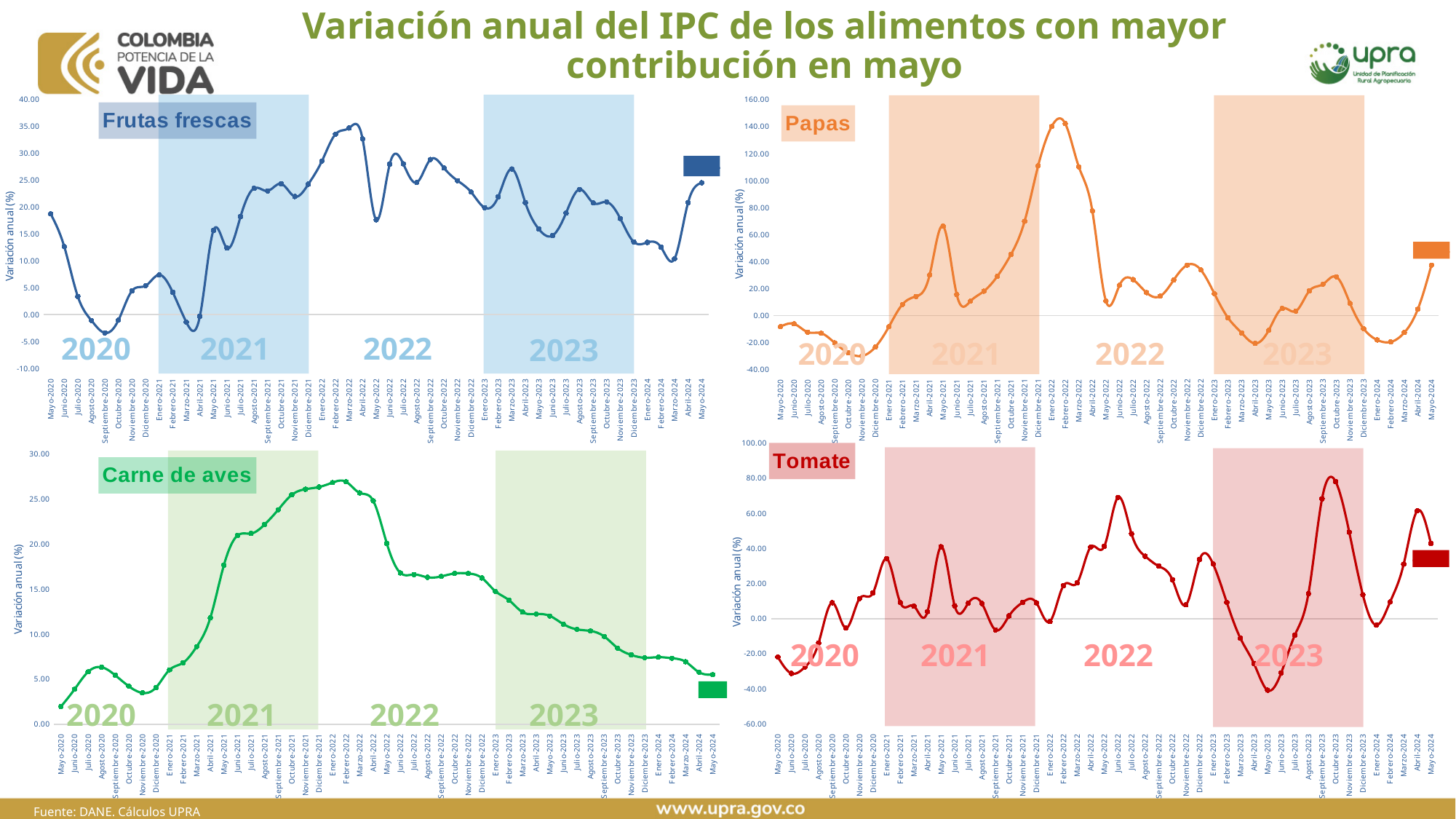
In which year does the Tomate chart reach its lowest value? 2023 In the Papas chart, is the value for Febrero-2022 greater or less than 120? greater In the Carne de aves chart, do the values rise or fall from Enero-2023 to Mayo-2024? fall In the Frutas frescas chart, is the value for Mayo-2020 greater or less than 15? greater What is the label on the vertical axis of the Tomate chart? Variación anual (%) In the Tomate chart, is the value for Mayo-2023 greater or less than -20? less What kind of chart is the Frutas frescas chart? line chart In which year does the Papas chart reach its highest value? 2022 How many charts are shown on the slide? 4 In the Carne de aves chart, which is larger, the value for Febrero-2022 or the value for Mayo-2024? Febrero-2022